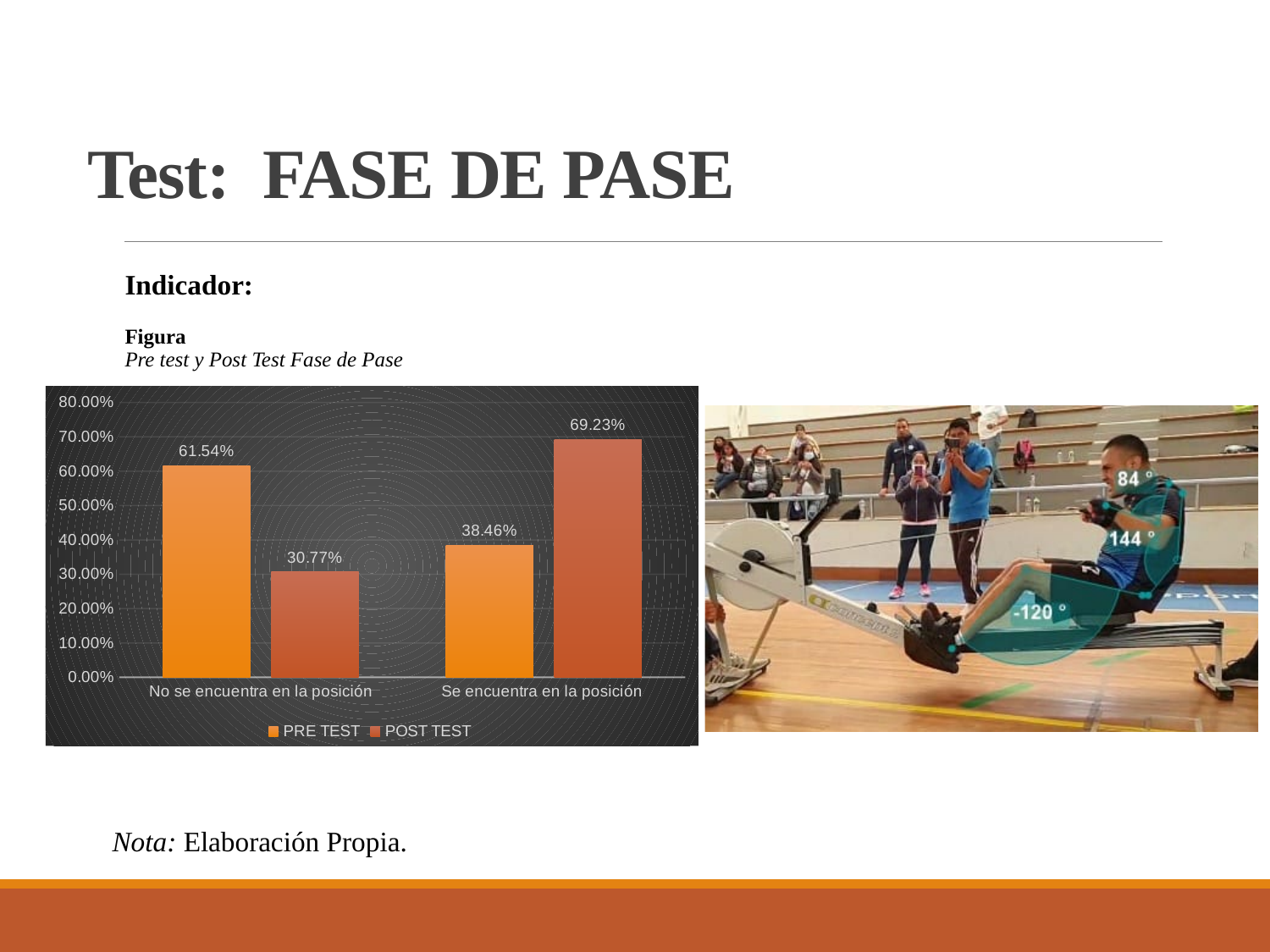
What type of chart is shown on the slide? Bar chart Which bar in the chart has the highest value? POST TEST, Se encuentra en la posición What is the difference between the PRE TEST and POST TEST values for 'No se encuentra en la posición'? 30.77% What is the POST TEST value for 'No se encuentra en la posición'? 30.77% How many series does the chart legend list? 2 How many categories are shown on the x axis of the chart? 2 Which bar in the chart has the lowest value? POST TEST, No se encuentra en la posición For 'Se encuentra en la posición', which is larger: PRE TEST or POST TEST? POST TEST What is the PRE TEST value for 'No se encuentra en la posición'? 61.54% What is the difference between the POST TEST and PRE TEST values for 'Se encuentra en la posición'? 30.77% What is the PRE TEST value for 'Se encuentra en la posición'? 38.46% What is the POST TEST value for 'Se encuentra en la posición'? 69.23%